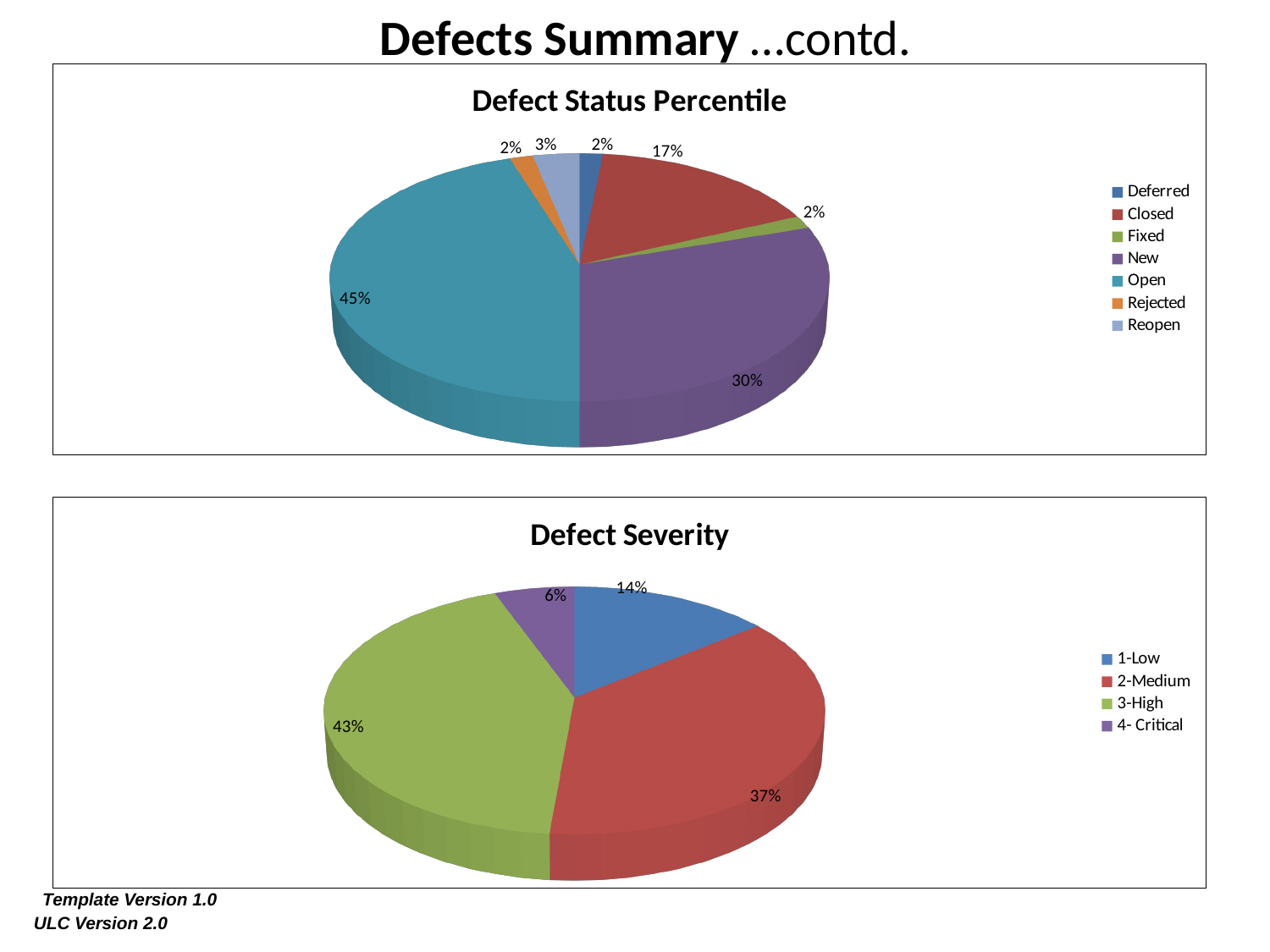
In the Defect Severity chart, what is the difference between the 3-High and 2-Medium percentages? 6% In the Defect Status Percentile chart, what percentage is labelled for New? 30% In the Defect Severity chart, which severity has the smallest slice? 4- Critical In the Defect Status Percentile chart, which status has the largest slice? Open In the Defect Status Percentile chart, what share of defects is Open? 45% In the Defect Status Percentile chart, how many categories does the legend list? 7 In the Defect Severity chart, what percentage of defects is 3-High? 43% In the Defect Status Percentile chart, what percentage is Closed? 17% In the Defect Severity chart, which is larger, 2-Medium or 1-Low? 2-Medium What kind of chart is the Defect Severity chart? Pie chart In the Defect Status Percentile chart, what is the difference between the Open and New percentages? 15% In the Defect Severity chart, what percentage is 4- Critical? 6%